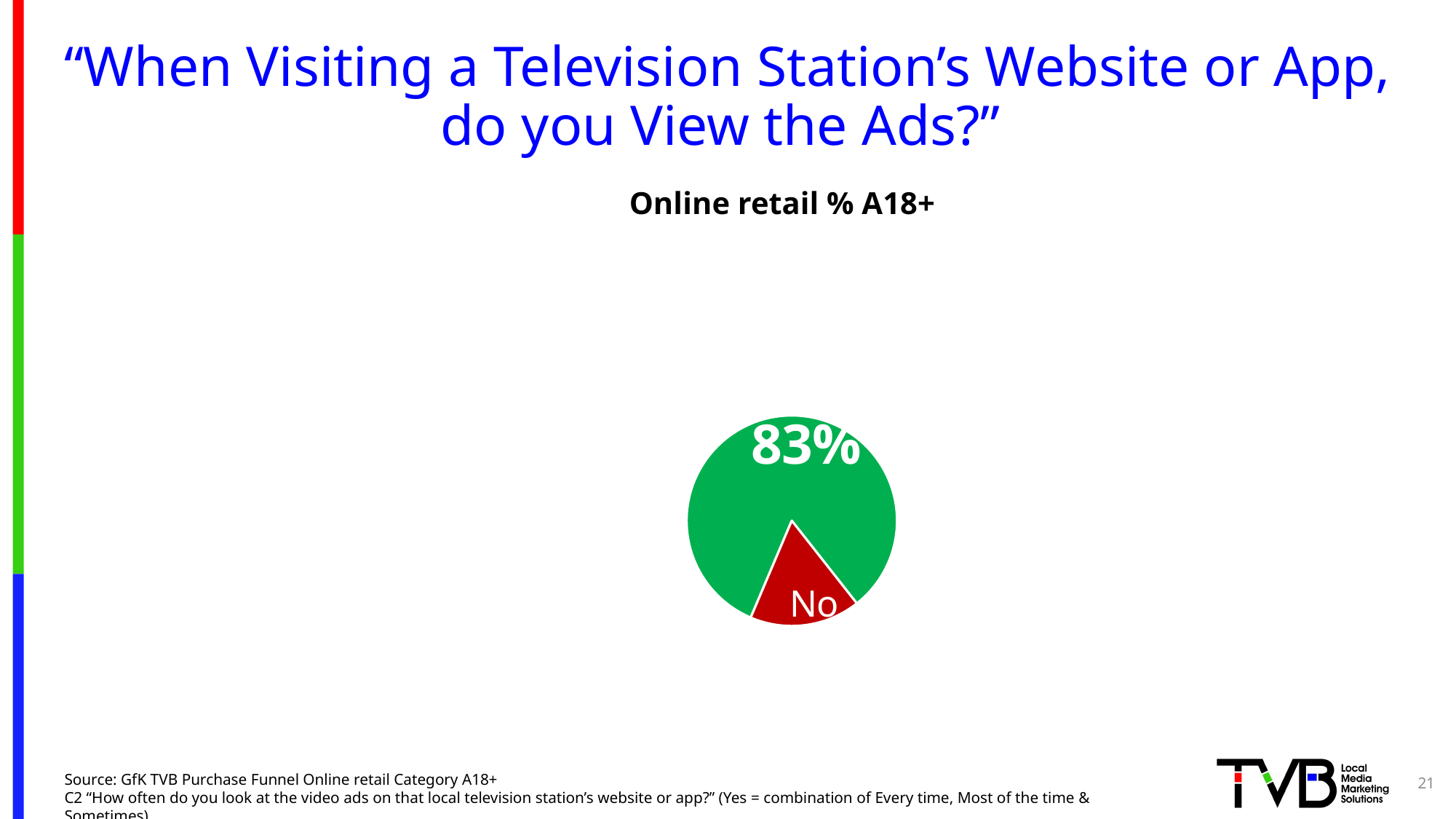
Which slice of the pie chart is larger, the green slice or the slice labeled "No"? the green slice What colour is the slice labeled "No" in the pie chart? red How many slices does the pie chart have? 2 What kind of chart is shown on the slide? pie chart What percentage is printed on the green slice of the pie chart? 83% Is the share of the slice labeled "No" greater or less than 50%? less What is the title of the pie chart? Online retail % A18+ Is the share of the green slice greater or less than 50%? greater Is the slice labeled "No" the largest or the smallest slice of the pie chart? smallest